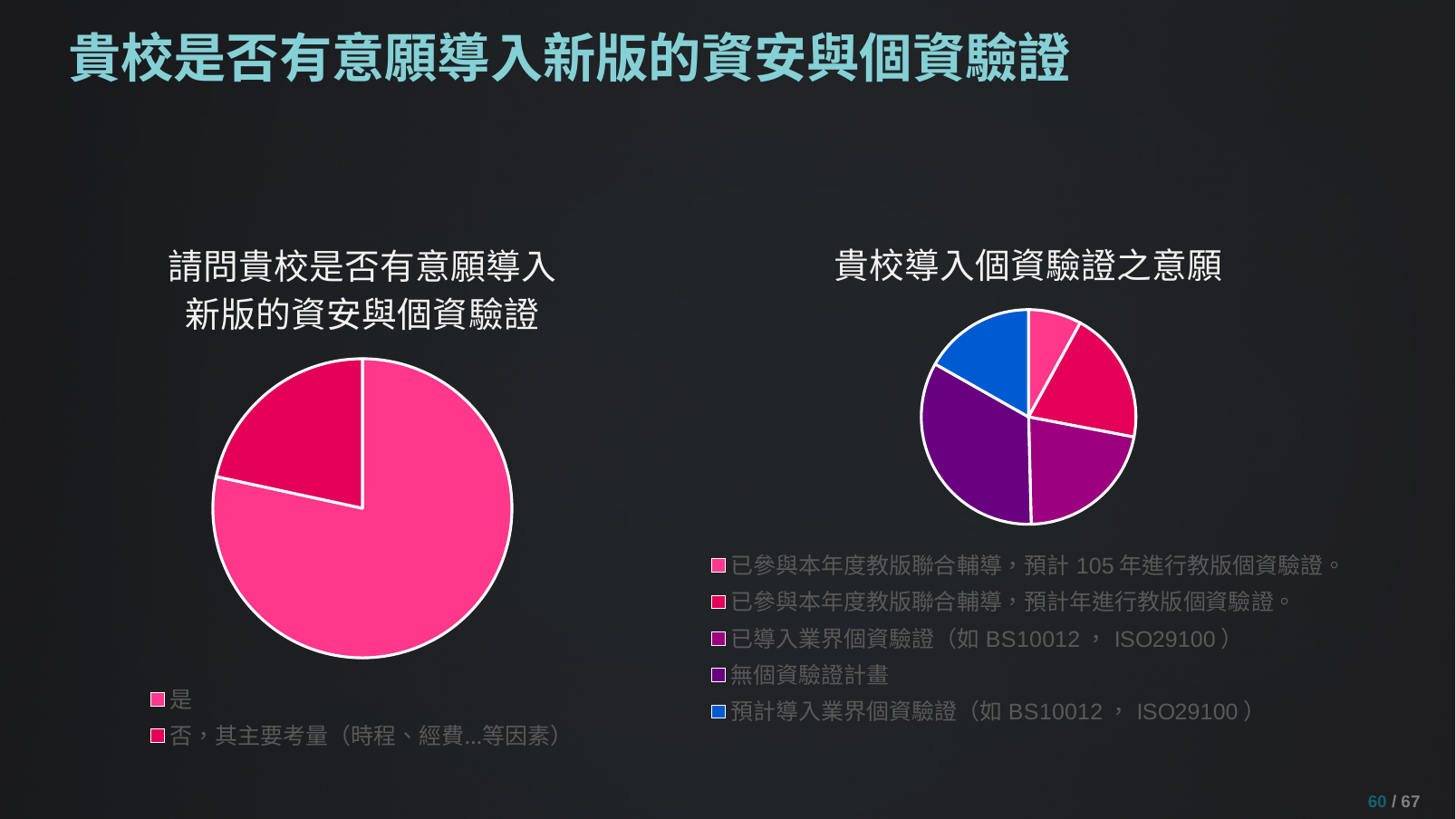
In the right chart titled 貴校導入個資驗證之意願, how many slices does the pie have? 5 In the left chart titled 請問貴校是否有意願導入新版的資安與個資驗證, which category has the smallest slice? 否，其主要考量（時程、經費...等因素） In the right chart titled 貴校導入個資驗證之意願, how many entries does the legend list? 5 What kind of chart is the right chart titled 貴校導入個資驗證之意願? Pie chart In the right chart titled 貴校導入個資驗證之意願, which category has the largest slice? 無個資驗證計畫 In the right chart titled 貴校導入個資驗證之意願, what colour is the slice for 無個資驗證計畫? Purple In the right chart titled 貴校導入個資驗證之意願, which slice is larger: 無個資驗證計畫 or 已導入業界個資驗證（如 BS10012， ISO29100）? 無個資驗證計畫 What kind of chart is the left chart titled 請問貴校是否有意願導入新版的資安與個資驗證? Pie chart In the left chart titled 請問貴校是否有意願導入新版的資安與個資驗證, how many slices does the pie have? 2 In the left chart titled 請問貴校是否有意願導入新版的資安與個資驗證, which category has the largest slice? 是 In the right chart titled 貴校導入個資驗證之意願, which slice is larger: 預計導入業界個資驗證（如 BS10012， ISO29100） or 已參與本年度教版聯合輔導，預計 105 年進行教版個資驗證。? 預計導入業界個資驗證（如 BS10012， ISO29100） In the right chart titled 貴校導入個資驗證之意願, which category has the smallest slice? 已參與本年度教版聯合輔導，預計 105 年進行教版個資驗證。